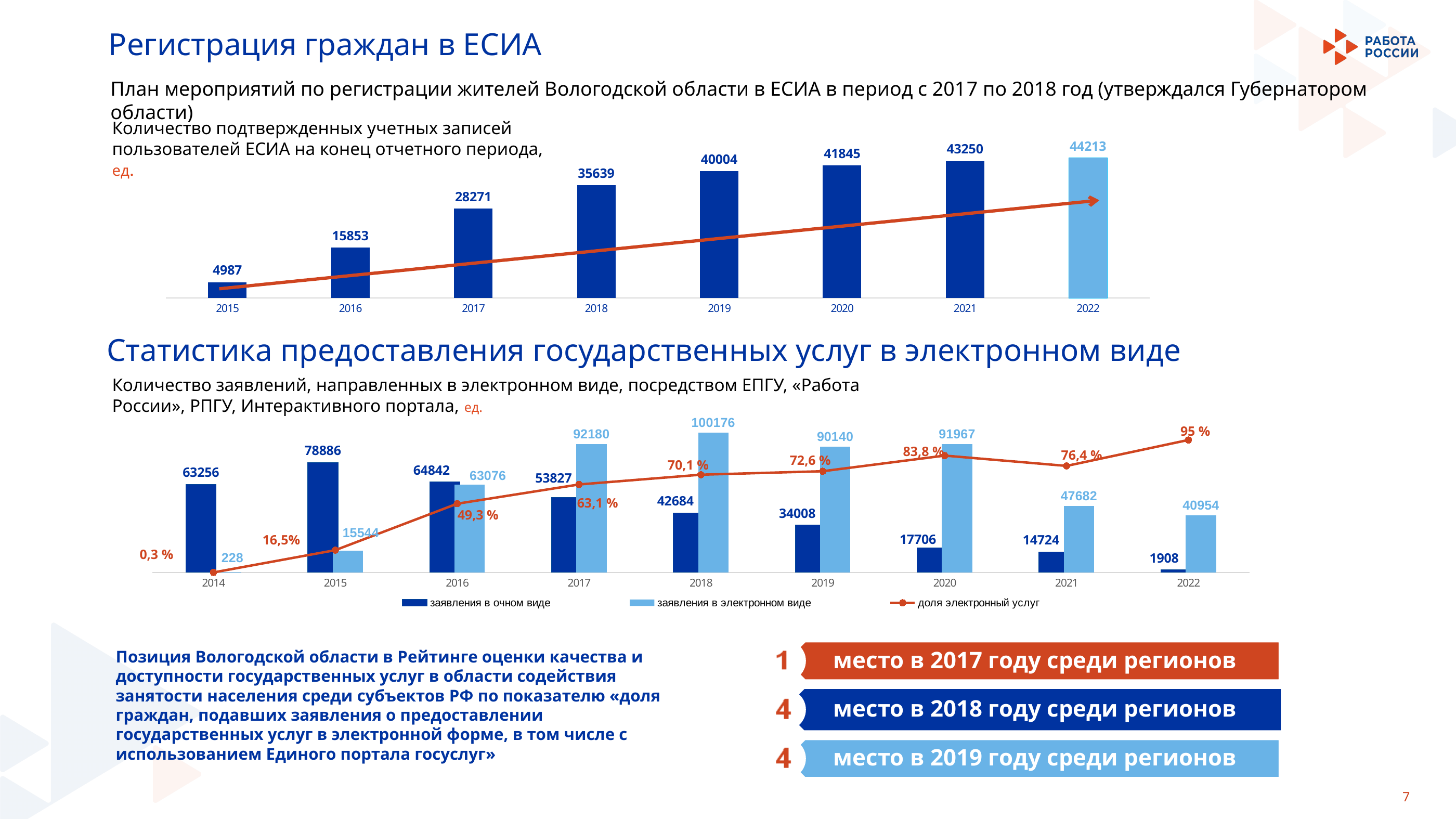
In the bottom chart, how many series does the legend list? 3 In the bottom chart, how many applications were submitted electronically (заявления в электронном виде) in 2018? 100176 In the bottom chart, which year has the highest number of in-person applications (заявления в очном виде)? 2015 In the top chart, do the values rise or fall from 2015 to 2022? rise In the top chart, what is the difference between the 2022 and 2021 values? 963 In the bottom chart, what is the total number of applications (in-person plus electronic) in 2022? 42862 In the top chart, what is the number of confirmed ESIA user accounts at the end of 2019? 40004 In the bottom chart, which is larger in 2016: in-person applications or electronic applications? in-person applications (64842) In the top chart, how many years are shown on the x axis? 8 In the top chart, which year has the lowest number of confirmed ESIA accounts? 2015 In the bottom chart, what is the share of electronic services (доля электронный услуг) in 2020? 83,8 % What type of chart is the top chart? bar chart